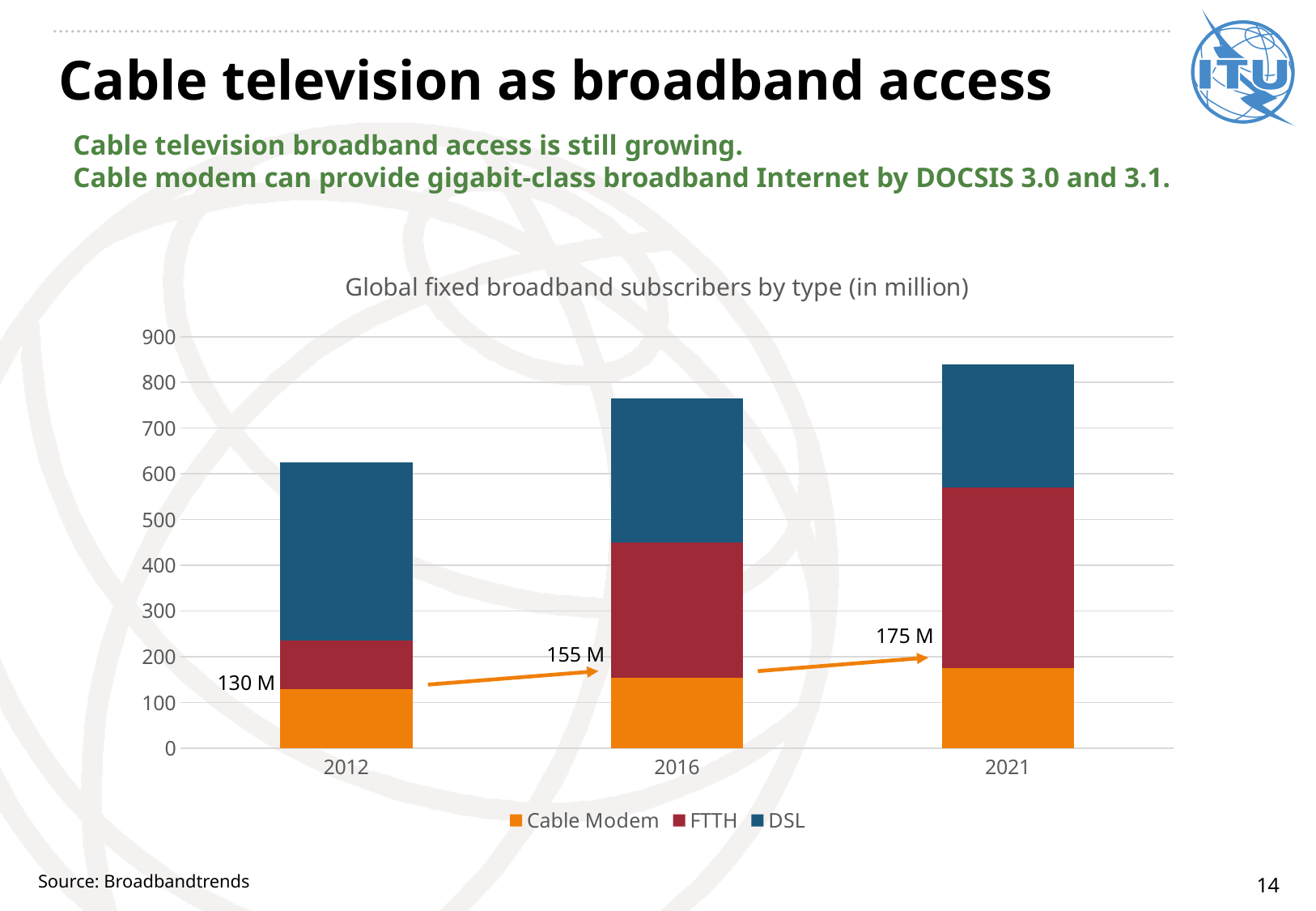
What is the labelled value for Cable Modem in 2016? 155 M Is the total height of the 2016 bar greater or less than 800? less What is the labelled value for Cable Modem in 2012? 130 M Do the Cable Modem values rise or fall from 2012 to 2021? Rise By how much did the Cable Modem value increase from 2012 to 2021? 45 M Which year has the highest total stacked bar? 2021 How many series does the legend list? 3 What is the title of the chart? Global fixed broadband subscribers by type (in million) How many years are shown on the x axis? 3 In 2012, which segment is larger: DSL or FTTH? DSL What is the labelled value for Cable Modem in 2021? 175 M What kind of chart is shown on the slide? Stacked bar chart